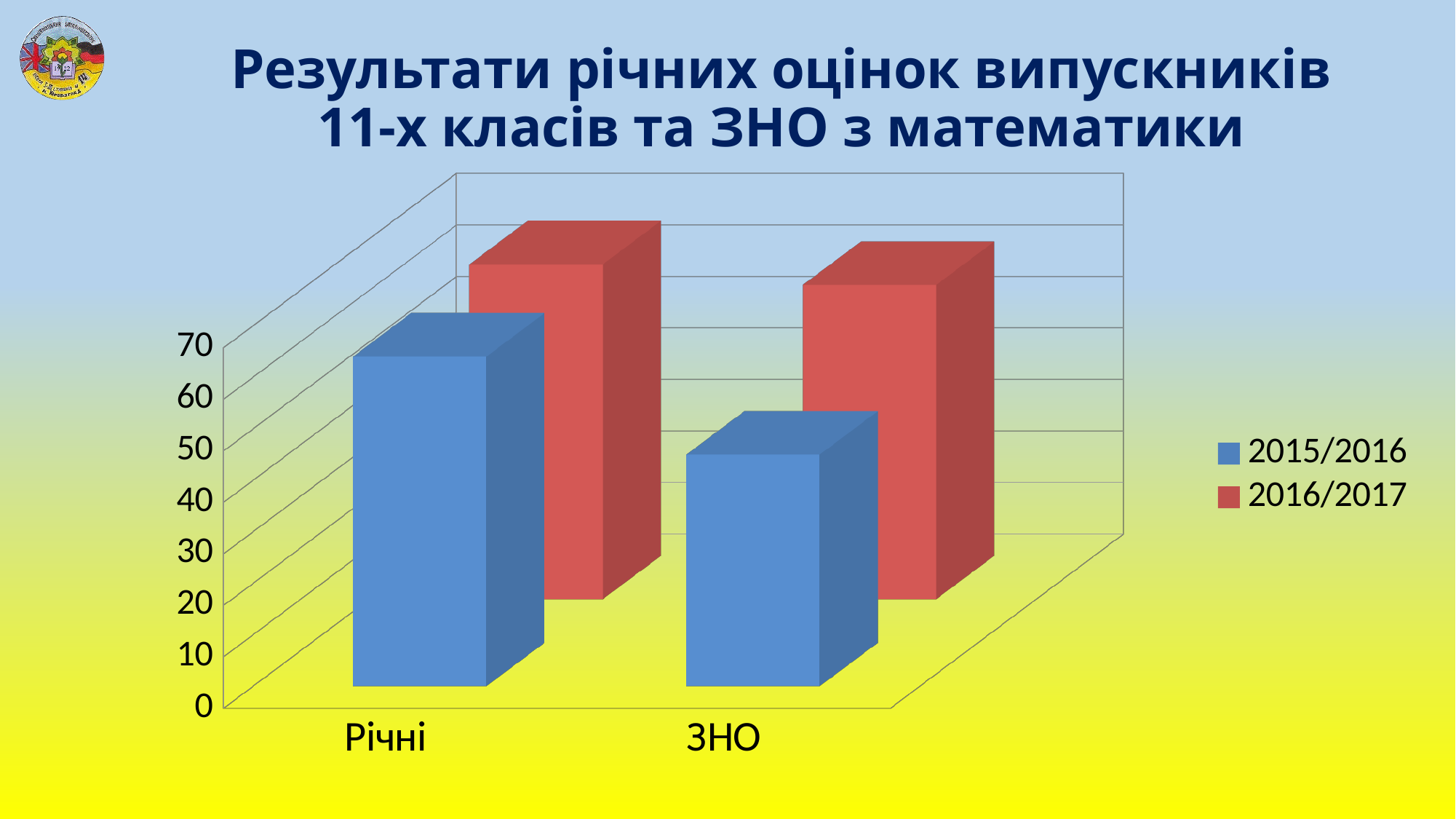
How many categories are shown on the x axis of the chart? 2 Is the value for Річні in the 2015/2016 series greater or less than 70? less Which colour represents the 2016/2017 series in the chart? red Is the value for ЗНО in the 2016/2017 series greater or less than 50? greater Is the value for ЗНО in the 2015/2016 series greater or less than 50? less For the ЗНО category, which series has the larger value, 2015/2016 or 2016/2017? 2016/2017 How many series does the chart's legend list? 2 In the 2015/2016 series, which category has the lowest value? ЗНО Which two series are listed in the chart's legend? 2015/2016 and 2016/2017 What kind of chart is shown on the slide? bar chart Do the values in the 2015/2016 series rise or fall from Річні to ЗНО? fall